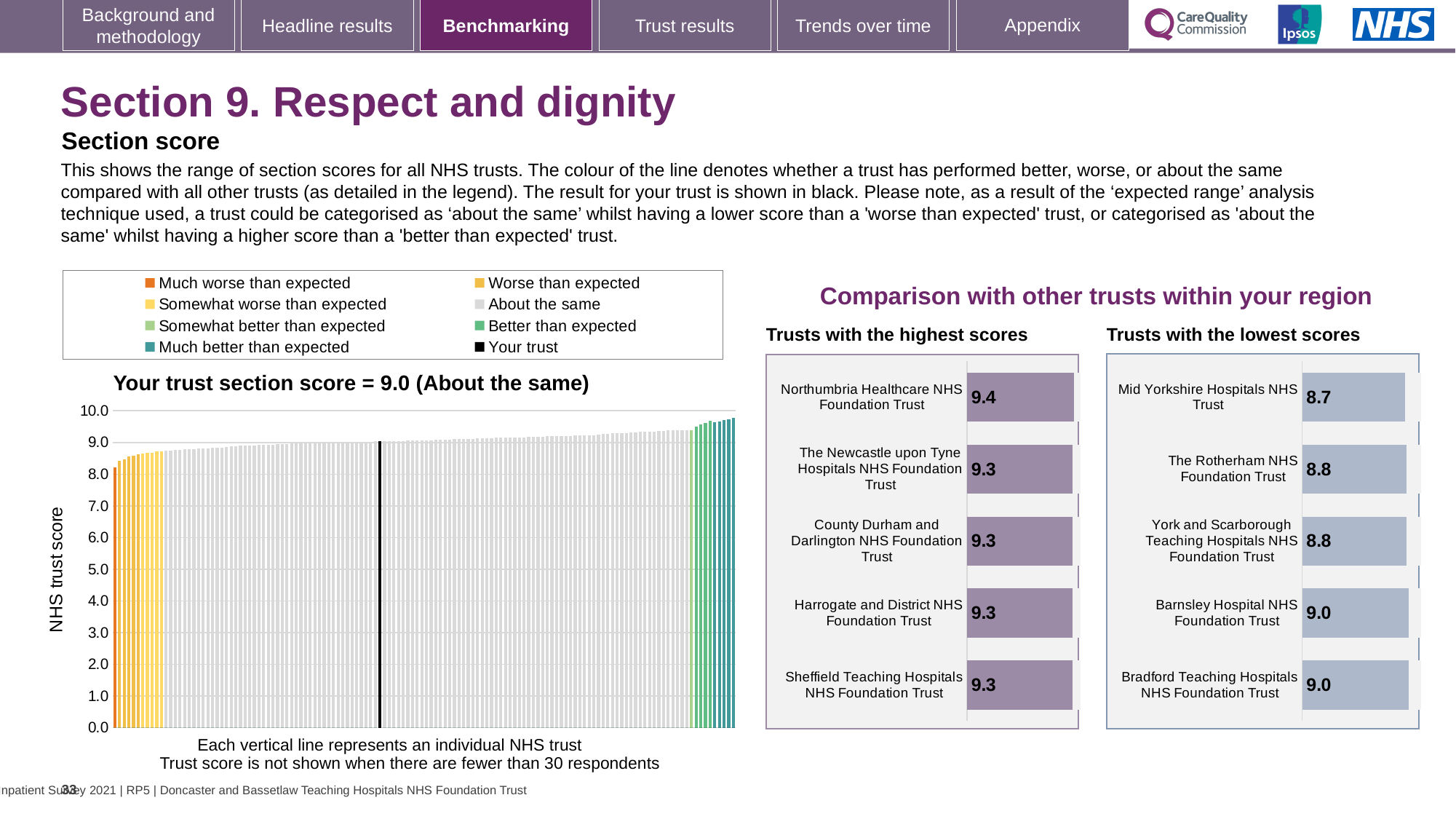
In the 'Your trust section score' chart on the left, what is the section score for your trust? 9.0 In the 'Trusts with the lowest scores' chart, which has the larger score: The Rotherham NHS Foundation Trust or Barnsley Hospital NHS Foundation Trust? Barnsley Hospital NHS Foundation Trust In the 'Trusts with the lowest scores' chart, what is the score for Mid Yorkshire Hospitals NHS Trust? 8.7 How many entries does the legend above the 'Your trust section score' chart list? 8 In the 'Trusts with the lowest scores' chart, which trust has the lowest score? Mid Yorkshire Hospitals NHS Trust In the 'Trusts with the lowest scores' chart, what is the difference between the scores of Barnsley Hospital NHS Foundation Trust and Mid Yorkshire Hospitals NHS Trust? 0.3 In the 'Trusts with the highest scores' chart, what is the difference between the scores of Northumbria Healthcare NHS Foundation Trust and The Newcastle upon Tyne Hospitals NHS Foundation Trust? 0.1 What kind of chart is the 'Your trust section score' chart on the left? Bar chart In the 'Trusts with the highest scores' chart, which trust has the highest score? Northumbria Healthcare NHS Foundation Trust In the 'Your trust section score' chart on the left, is the value of the highest bar greater or less than 10.0? less In the 'Trusts with the highest scores' chart, what is the score for Northumbria Healthcare NHS Foundation Trust? 9.4 How many trusts are listed in the 'Trusts with the highest scores' chart? 5